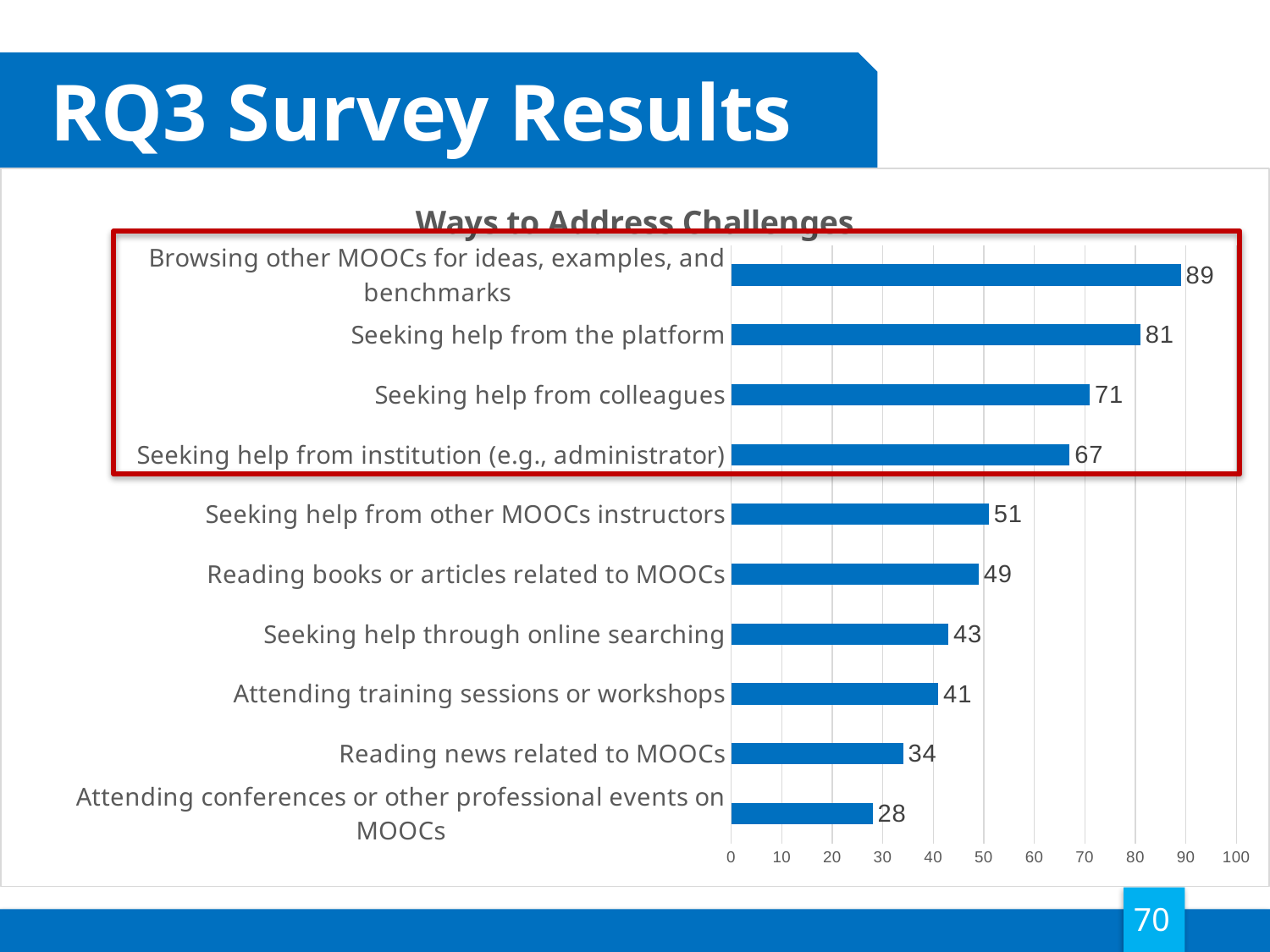
Which is larger: "Seeking help from other MOOCs instructors" or "Attending training sessions or workshops"? Seeking help from other MOOCs instructors What is the difference between "Seeking help from colleagues" and "Seeking help from institution (e.g., administrator)"? 4 Is the value for "Reading books or articles related to MOOCs" greater or less than 60? less What is the value for "Seeking help through online searching"? 43 What is the title of the chart? Ways to Address Challenges Which category has the highest value? Browsing other MOOCs for ideas, examples, and benchmarks How many categories are shown in the chart? 10 How many categories are enclosed by the red box on the chart? 4 What kind of chart is shown on the slide? Bar chart What is the value for "Reading news related to MOOCs"? 34 Which category has the lowest value? Attending conferences or other professional events on MOOCs What is the value for "Seeking help from the platform"? 81